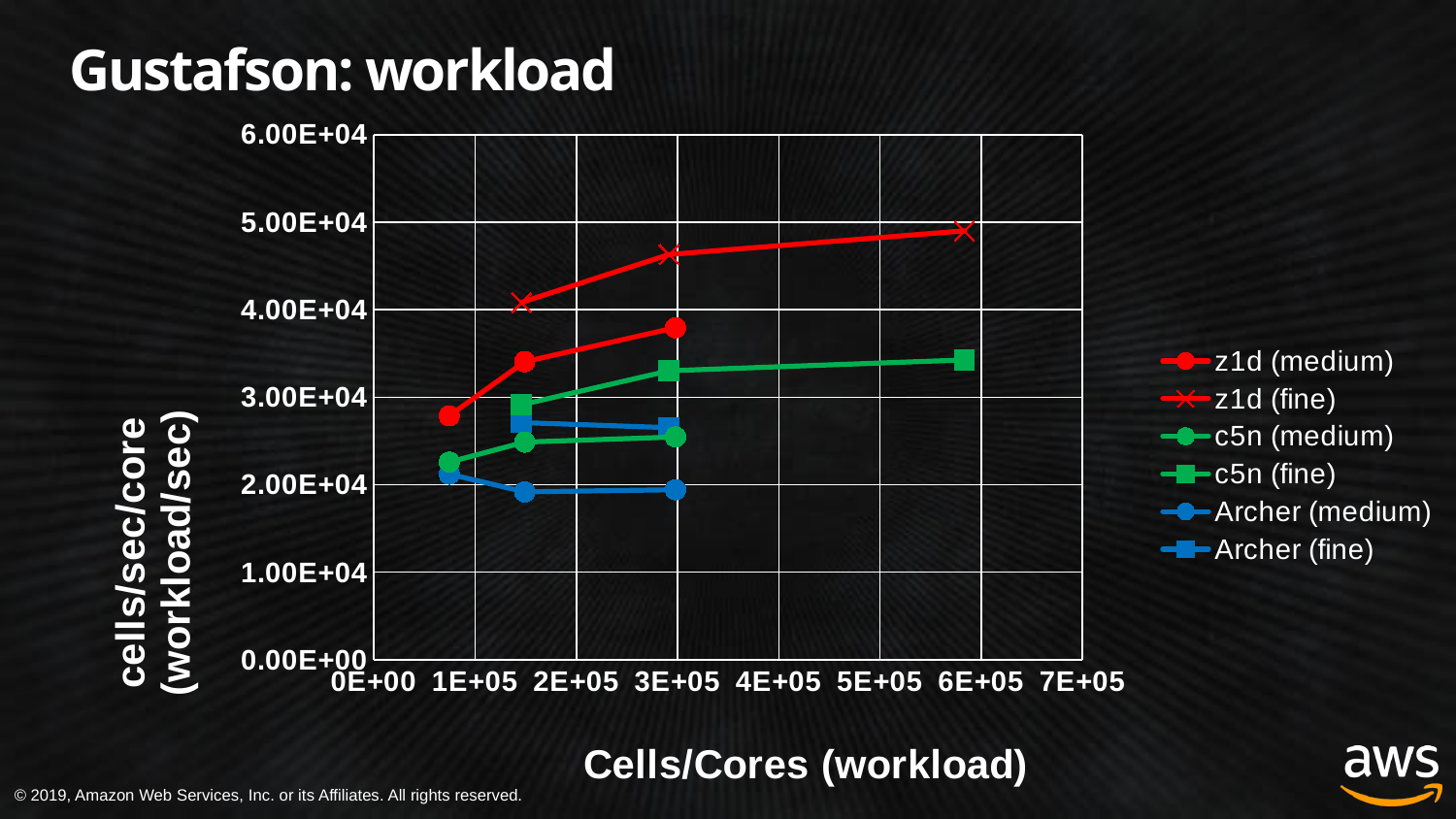
What is the label of the x axis? Cells/Cores (workload) How many series does the legend list? 6 Is the value for Archer (fine) at its rightmost point greater or less than 3.00E+04? less Is the value for c5n (fine) at its rightmost point greater or less than 3.00E+04? greater At a workload of about 3E+05, which is larger: z1d (fine) or z1d (medium)? z1d (fine) Do the values for z1d (fine) rise or fall as the workload increases along the x axis? rise What kind of chart is shown on the slide? line chart Which series has the lowest values on the chart? Archer (medium) Is the value for z1d (fine) at its rightmost point greater or less than 4.00E+04? greater How many data points are plotted for the Archer (fine) series? 2 Which series reaches the highest value on the chart? z1d (fine) What is the title of the chart? Gustafson: workload